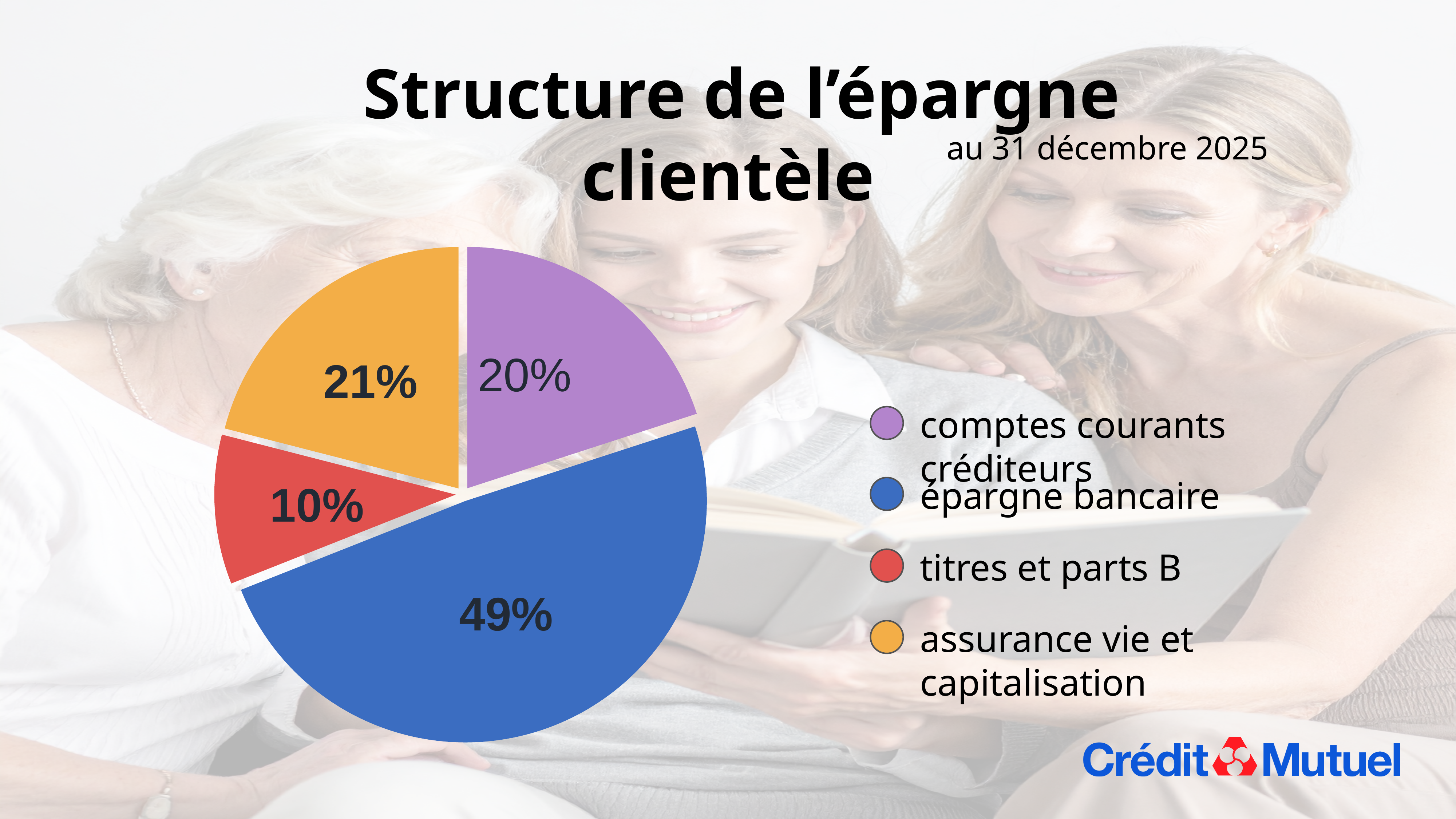
Which is larger, the share for assurance vie et capitalisation or the share for comptes courants créditeurs? assurance vie et capitalisation What is the difference in percentage points between épargne bancaire and assurance vie et capitalisation? 28 What kind of chart is shown on the slide? pie chart Which category has the smallest share of the pie? titres et parts B What share of the pie does épargne bancaire represent? 49% What is the value shown for titres et parts B? 10% How many categories does the pie chart show? 4 What is the value shown for comptes courants créditeurs? 20% What date is given under the chart title? au 31 décembre 2025 Which category has the largest share of the pie? épargne bancaire What is the value shown for assurance vie et capitalisation? 21% What colour is the slice for titres et parts B? red